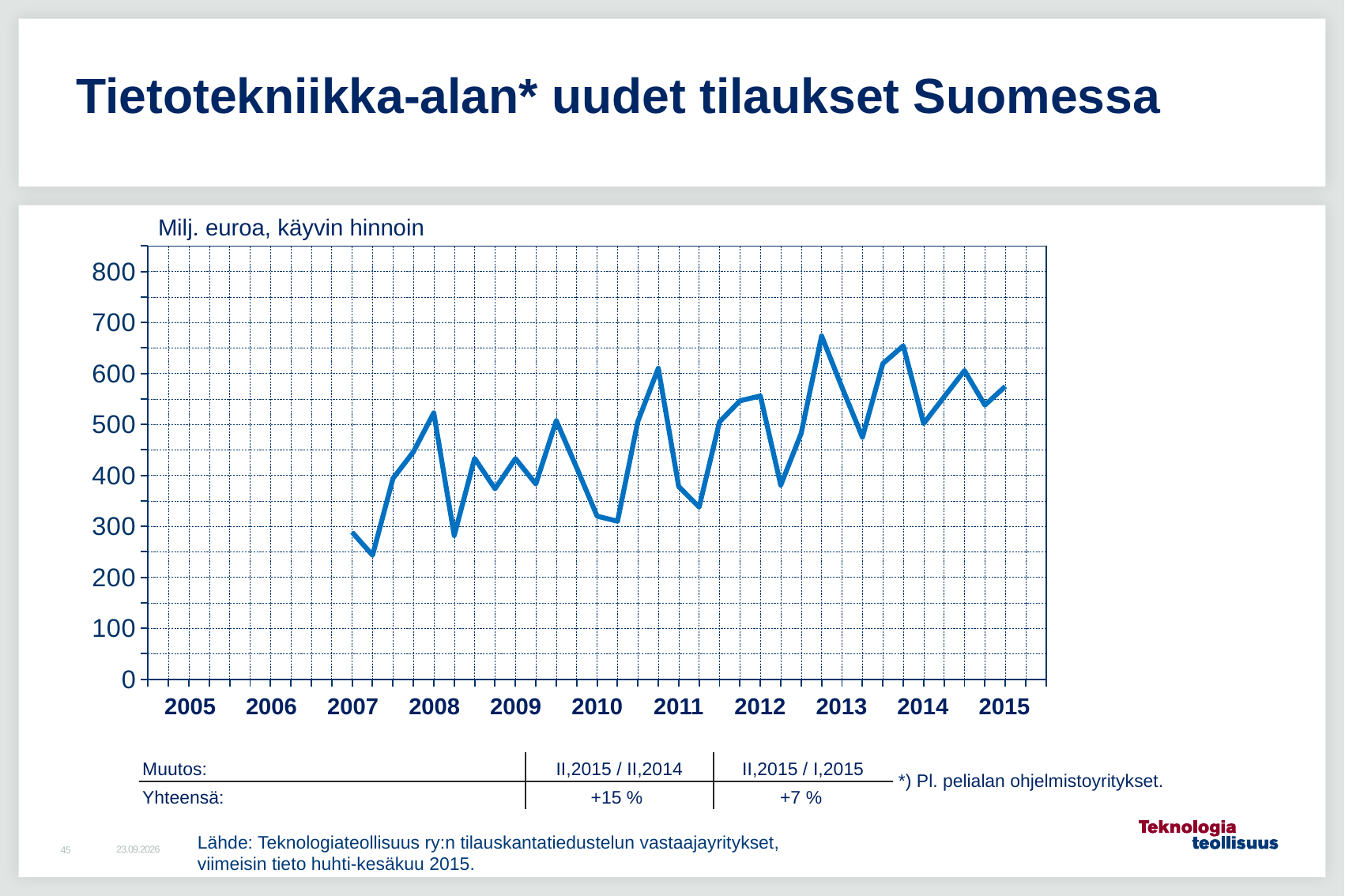
Is the last plotted value in 2015 greater or less than 500? greater What change is given for II,2015 / II,2014 in the table below the chart? +15 % What kind of chart is shown on the slide? line chart Is the lowest value of the line in 2007 greater or less than 300? less In which year does the line reach its lowest point? 2007 What unit label is shown above the y axis of the chart? Milj. euroa, käyvin hinnoin How many data series are plotted in the chart? 1 What is the title of the slide's chart? Tietotekniikka-alan* uudet tilaukset Suomessa How many year labels are shown on the x axis? 11 Is the peak value reached in late 2012 greater or less than 600? greater Overall, does the line rise or fall from 2007 to 2015? rise